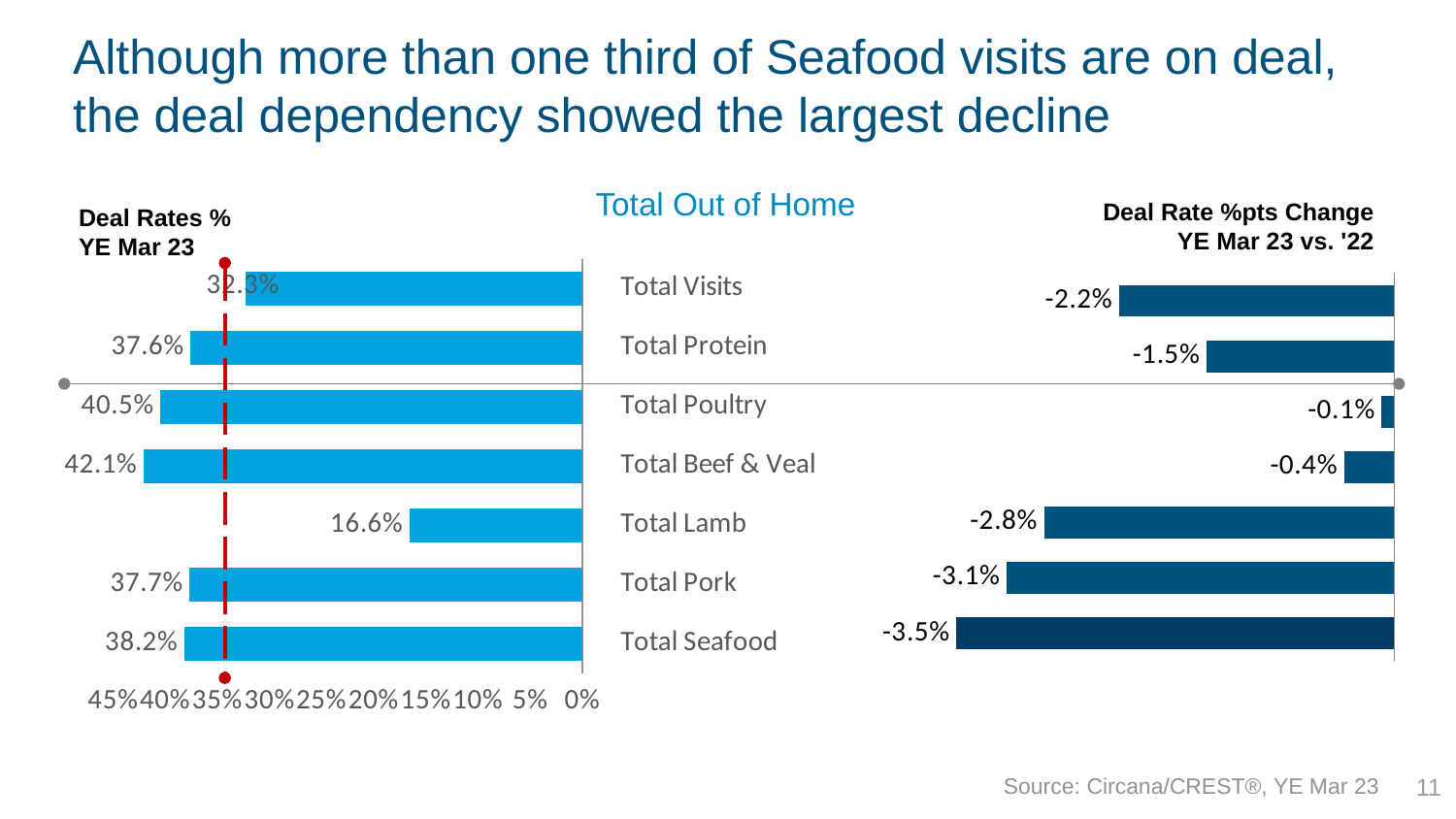
In the Deal Rates % YE Mar 23 chart, what is the deal rate for Total Seafood? 38.2% In the Deal Rate %pts Change YE Mar 23 vs. '22 chart, which category shows the largest decline? Total Seafood In the Deal Rate %pts Change YE Mar 23 vs. '22 chart, what is the value for Total Seafood? -3.5% In the Deal Rates % YE Mar 23 chart, which category has the lowest deal rate? Total Lamb In the Deal Rates % YE Mar 23 chart, what is the deal rate for Total Lamb? 16.6% In the Deal Rate %pts Change YE Mar 23 vs. '22 chart, what is the value for Total Poultry? -0.1% What type of chart is the Deal Rate %pts Change YE Mar 23 vs. '22 chart? Bar chart In the Deal Rates % YE Mar 23 chart, which category has the highest deal rate? Total Beef & Veal In the Deal Rates % YE Mar 23 chart, what is the difference between the deal rates for Total Poultry and Total Protein? 2.9% How many categories are shown in the Deal Rates % YE Mar 23 chart? 7 In the Deal Rate %pts Change YE Mar 23 vs. '22 chart, which category shows the smallest change? Total Poultry In the Deal Rate %pts Change YE Mar 23 vs. '22 chart, which declined more, Total Pork or Total Lamb? Total Pork